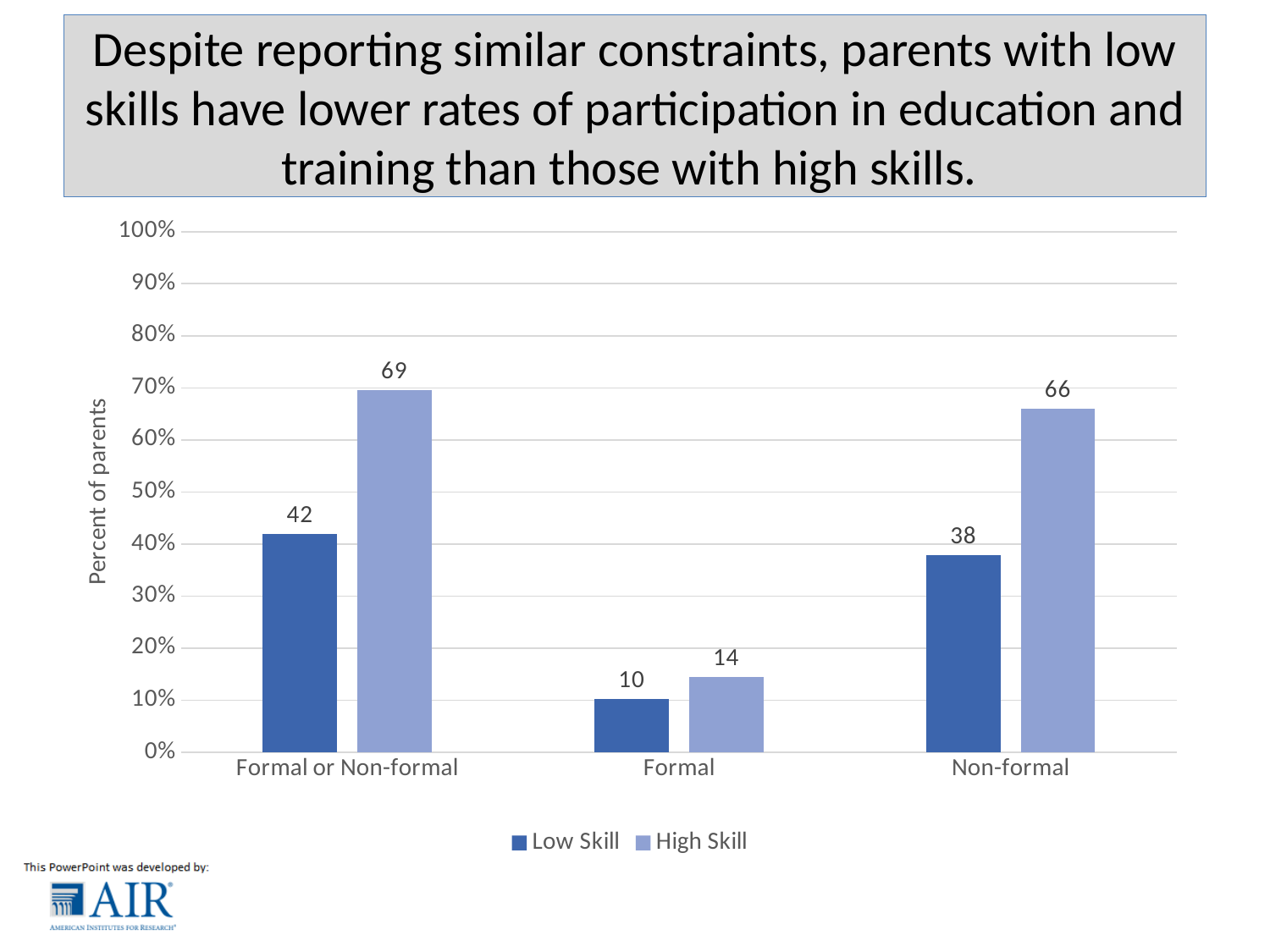
How many series does the legend list? 2 What is the value for High Skill in the Non-formal category? 66 What is the difference between the High Skill and Low Skill values in the Non-formal category? 28 What is the value for High Skill in the Formal category? 14 Is the Low Skill value for Non-formal greater or less than 40%? less Which category has the lowest Low Skill value? Formal Which category has the highest High Skill value? Formal or Non-formal What is the difference between the High Skill and Low Skill values in the Formal or Non-formal category? 27 Which is larger in the Formal category, the Low Skill value or the High Skill value? High Skill What kind of chart is shown on the slide? bar chart How many categories are shown on the x axis? 3 What is the value for Low Skill in the Formal or Non-formal category? 42